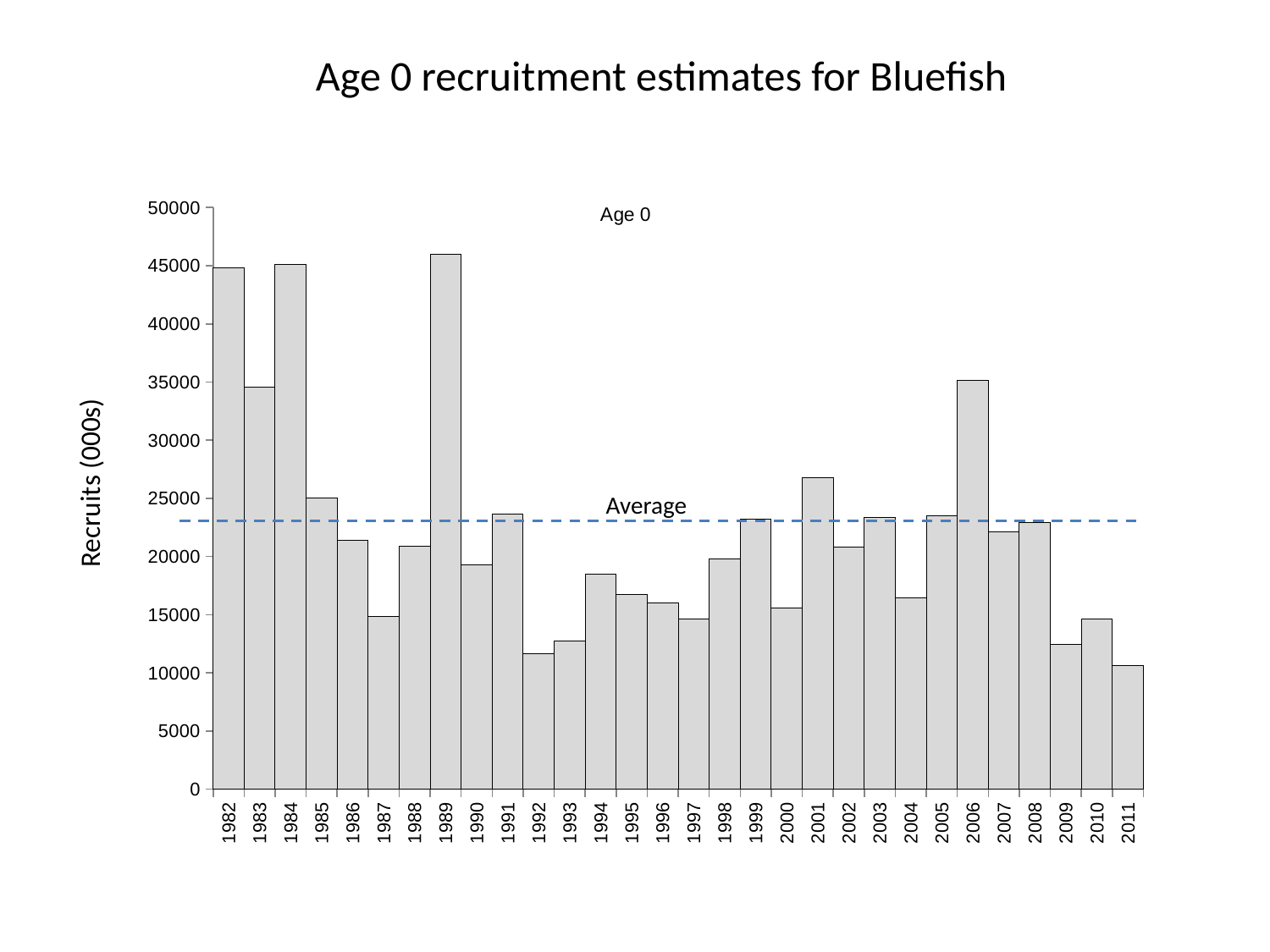
Which year has the larger value, 1997 or 1998? 1998 Is the value for 1992 greater or less than 15000? less Is the value for 2006 greater or less than 30000? greater Which year has the highest Age 0 recruitment estimate? 1989 Is the value for 1987 greater or less than 20000? less Do the values generally rise or fall from 2006 to 2011? fall Which year has the larger value, 1982 or 1983? 1982 What is the label on the vertical axis of the chart? Recruits (000s) How many years (bars) are plotted on the chart? 30 What kind of chart is shown on the slide? bar chart Which year has the lowest Age 0 recruitment estimate? 2011